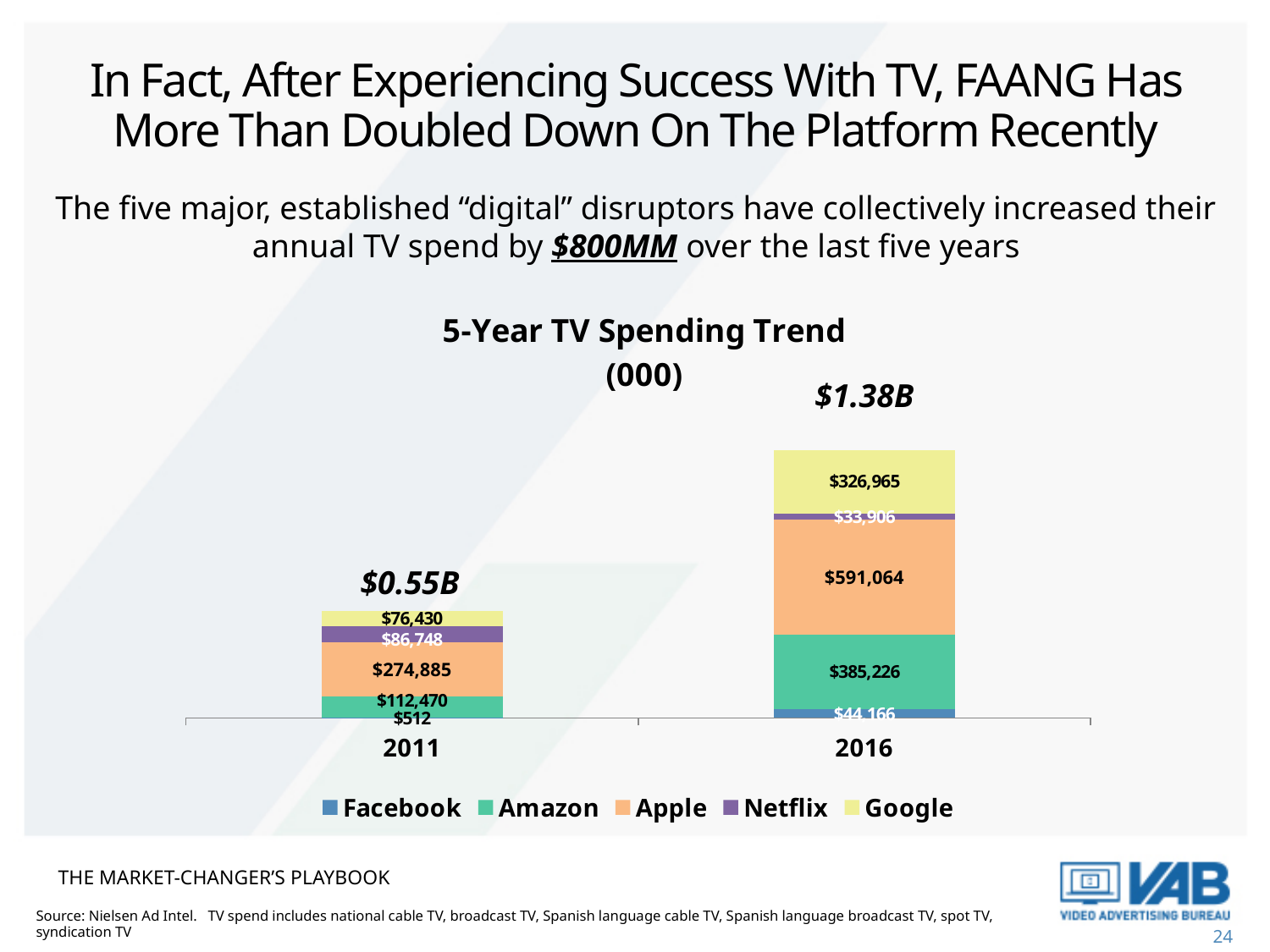
Which company has the smallest segment in the 2011 bar? Facebook What is the value for Apple in 2016? $591,064 What kind of chart is shown on the slide? Stacked bar chart By how much did Apple's value increase from 2011 to 2016? $316,179 In 2011, which is larger: the value for Google or the value for Netflix? Netflix Which company has the largest segment in the 2016 bar? Apple What is the value for Amazon in 2011? $112,470 What is the value for Google in 2016? $326,965 How many series does the legend list? 5 How many years are shown on the x axis? 2 What is the value for Netflix in 2011? $86,748 By how much did Amazon's value increase from 2011 to 2016? $272,756